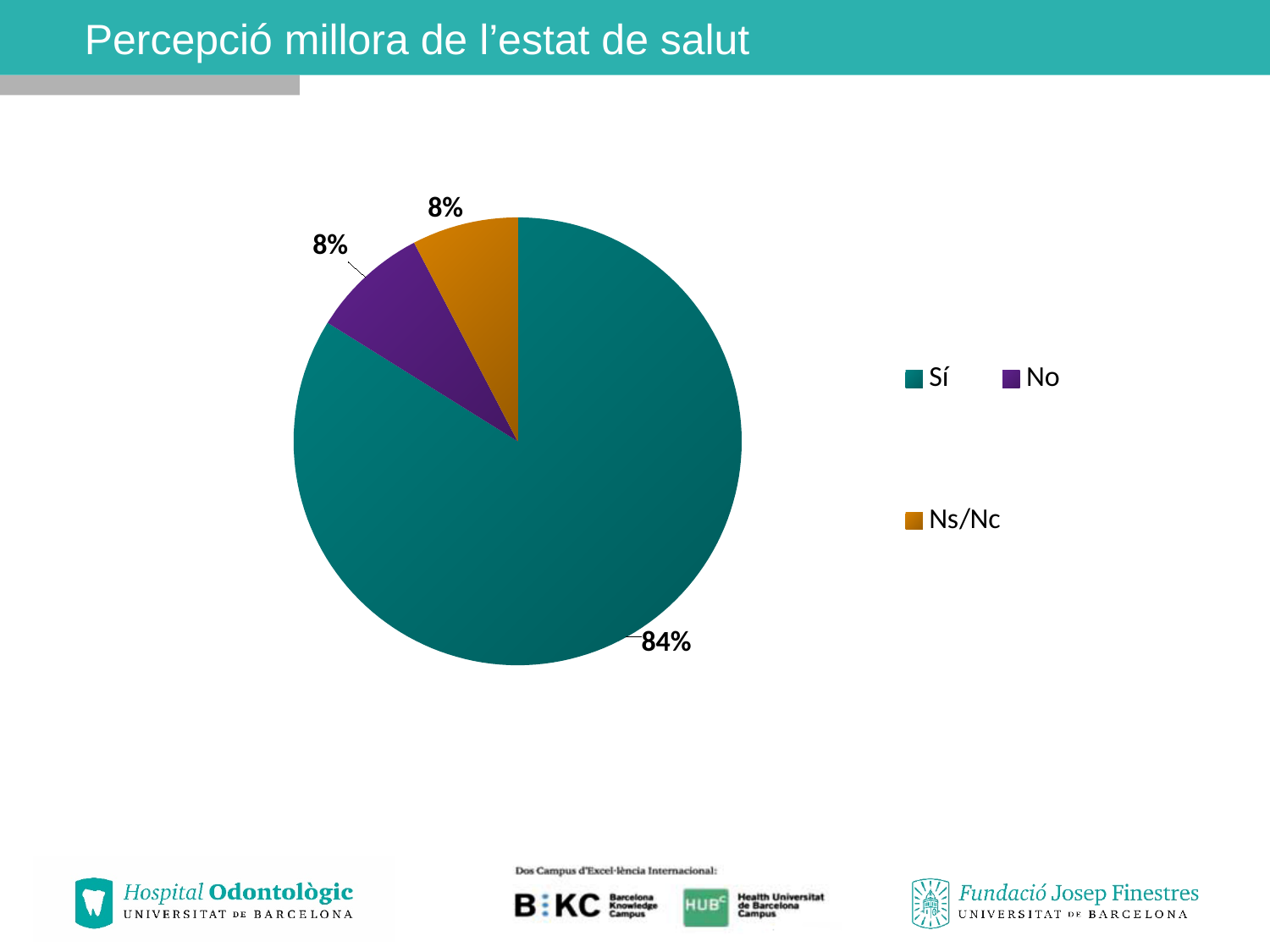
What colour is the "Sí" slice in the pie chart? teal Which category has the largest share of the pie? Sí What percentage of the pie does the "Sí" slice represent? 84% What percentage of the pie does the "No" slice represent? 8% What percentage of the pie does the "Ns/Nc" slice represent? 8% Which is larger, the "Sí" slice or the "Ns/Nc" slice? Sí How many slices does the pie chart have? 3 What kind of chart is shown on the slide? pie chart What is the title of the slide containing the pie chart? Percepció millora de l'estat de salut How many entries does the legend list? 3 What is the combined share of the "No" and "Ns/Nc" slices? 16% What is the difference in percentage points between the "Sí" slice and the "No" slice? 76